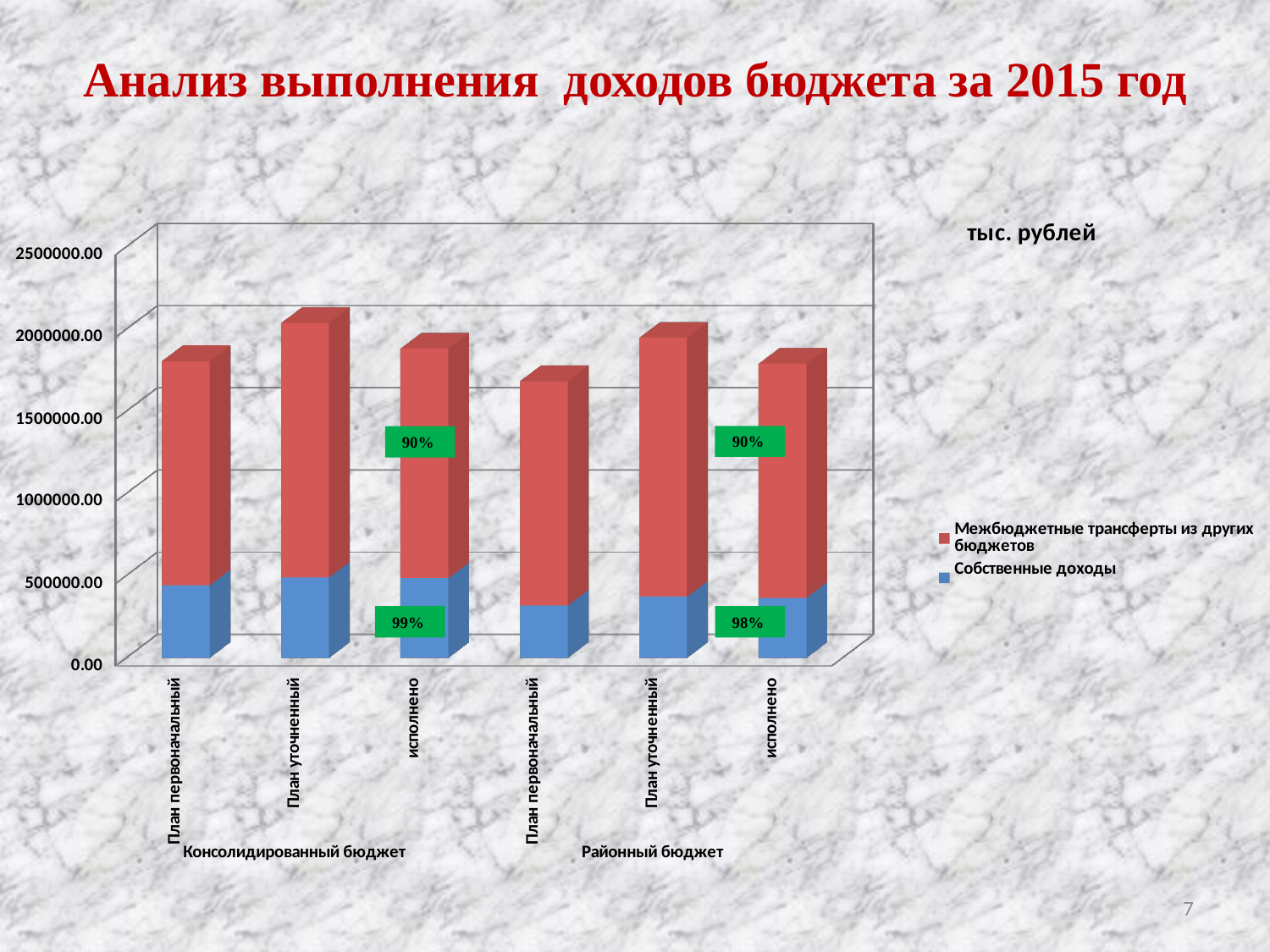
Which has a larger total value: План уточненный in Консолидированный бюджет or План первоначальный in Районный бюджет? План уточненный in Консолидированный бюджет What percentage label is shown on the Собственные доходы part of the исполнено bar for Консолидированный бюджет? 99% Is the total value for План первоначальный in Консолидированный бюджет greater or less than 1500000.00? greater Is the total value for План первоначальный in Районный бюджет greater or less than 2000000.00? less Which series is shown in blue according to the legend? Собственные доходы Is the value of Собственные доходы for План первоначальный in Районный бюджет greater or less than 500000.00? less What kind of chart is shown on the slide? Stacked bar chart Which bar has the highest total value? План уточненный (Консолидированный бюджет) How many series does the legend list? 2 Which bar has the lowest total value? План первоначальный (Районный бюджет) How many bars are plotted in the chart? 6 What unit of measurement is indicated next to the chart? тыс. рублей